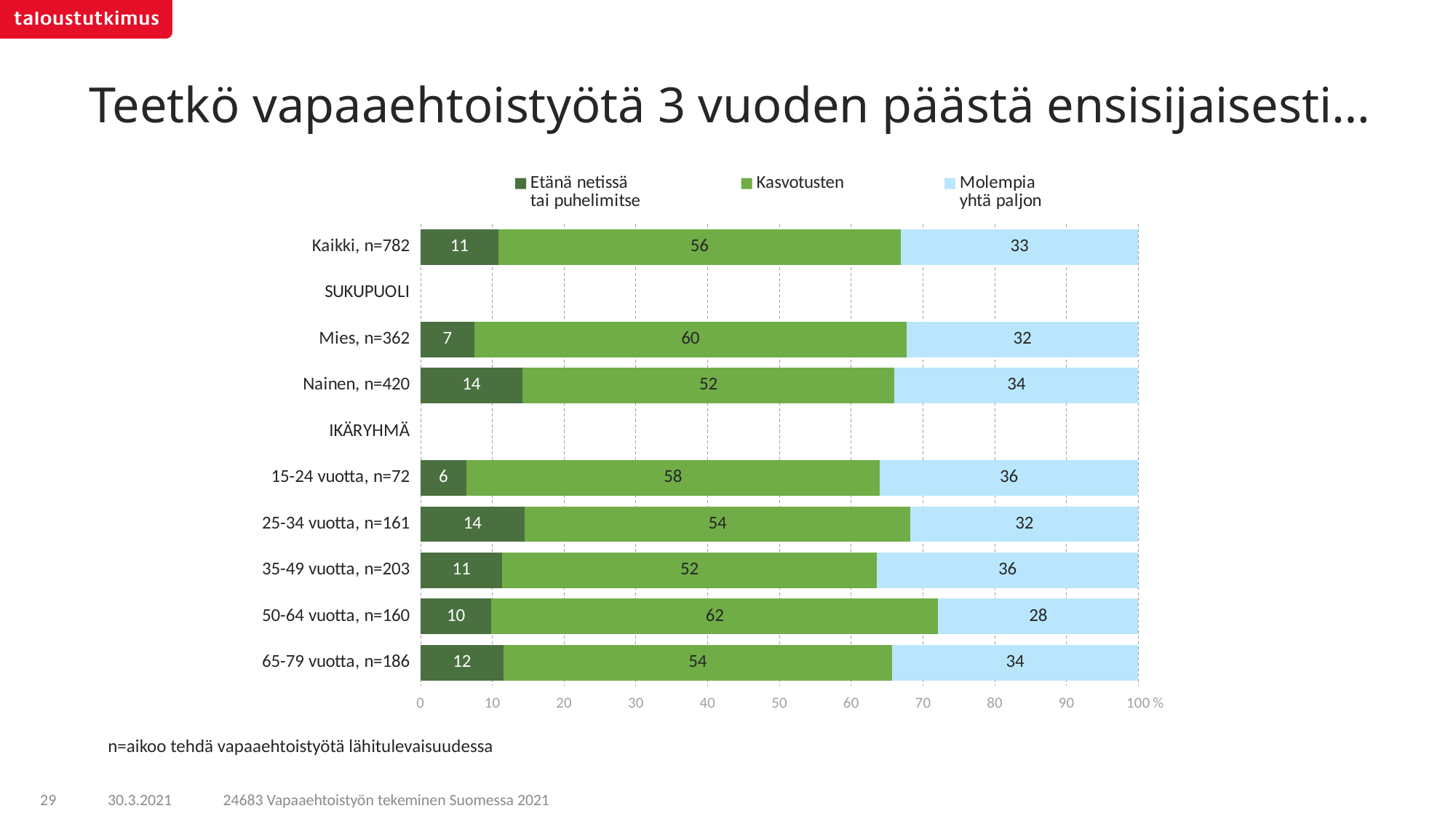
What kind of chart is shown on the slide? Stacked bar chart What is the difference between the Kasvotusten values for Mies, n=362 and Nainen, n=420? 8 How many age groups (IKÄRYHMÄ) are shown in the chart? 5 Which category has the lowest value for Etänä netissä tai puhelimitse? 15-24 vuotta, n=72 What is the value for Kasvotusten for Kaikki, n=782? 56 Which category has the highest value for Kasvotusten? 50-64 vuotta, n=160 How many series does the legend list? 3 Which is larger: the Molempia yhtä paljon value for 15-24 vuotta, n=72 or for 25-34 vuotta, n=161? 15-24 vuotta, n=72 What is the total of the stacked bar for 65-79 vuotta, n=186? 100 What is the value for Molempia yhtä paljon for 50-64 vuotta, n=160? 28 Which legend entry is shown in light blue? Molempia yhtä paljon What is the value for Etänä netissä tai puhelimitse for Nainen, n=420? 14